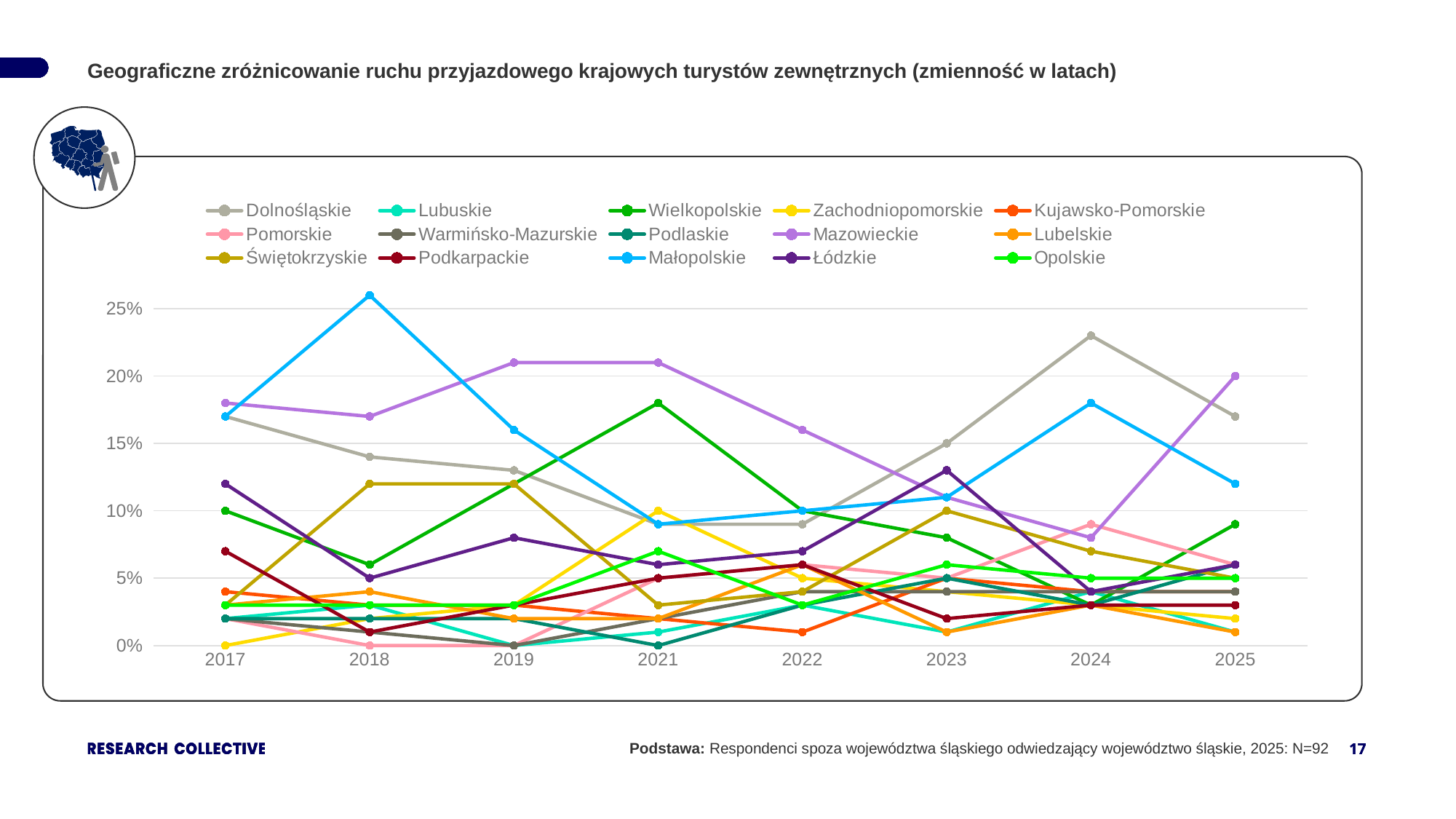
How many series does the legend list? 15 In 2024, which is larger: Dolnośląskie or Mazowieckie? Dolnośląskie How many years are shown on the x axis? 8 Which series reaches the highest point anywhere on the chart? Małopolskie Which series has the highest value in 2025? Mazowieckie What kind of chart is shown on the slide? Line chart Which series has the highest value in 2024? Dolnośląskie What is the value for Dolnośląskie in 2023? 15% Is the value for Dolnośląskie in 2024 greater or less than 20%? greater What is the value for Mazowieckie in 2025? 20% Is the value for Mazowieckie in 2021 greater or less than 15%? greater Does the Małopolskie line rise or fall from 2018 to 2021? Fall